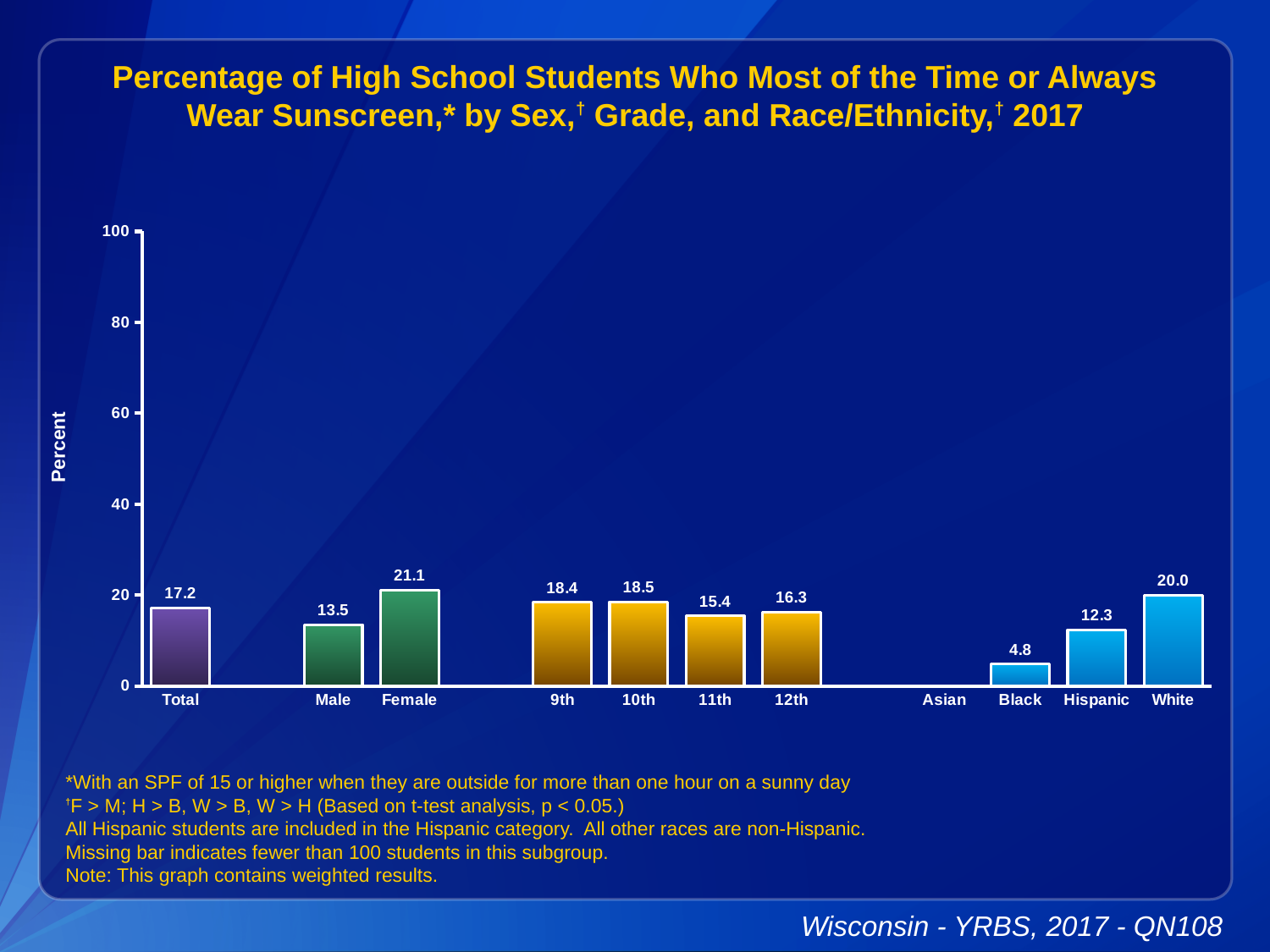
Which category has the highest value? Female Which category has no bar shown? Asian What is the value for Total? 17.2 What kind of chart is shown? bar chart Is the value for 9th grade greater or less than 20? less How many bars are plotted on the chart? 10 What is the value for Black? 4.8 Which is larger, the value for White or the value for Hispanic? White What is the difference between the Female and Male values? 7.6 Which category has the lowest value among the bars shown? Black What is the value for Female? 21.1 What is the label on the y axis? Percent